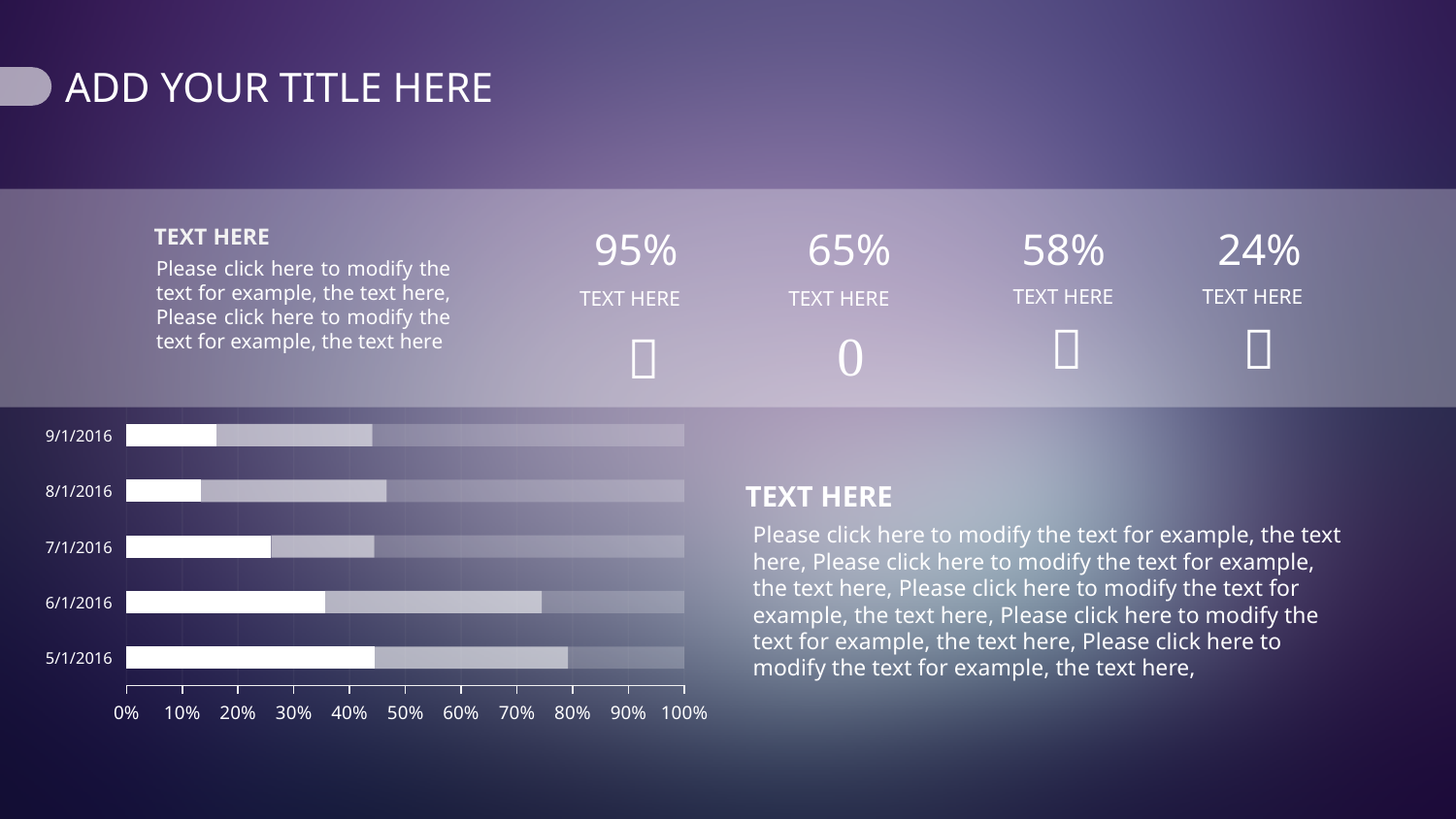
Which has the longer white (first) segment, 6/1/2016 or 7/1/2016? 6/1/2016 What is the interval between tick labels on the horizontal axis of the bar chart? 10% Which has the longer white (first) segment, 5/1/2016 or 9/1/2016? 5/1/2016 Which date has the longest white (first) segment in the bar chart? 5/1/2016 What kind of chart is shown on the slide? bar chart Is the white (first) segment for 7/1/2016 greater or less than 30%? less What is the maximum value shown on the horizontal axis of the bar chart? 100% Is the white (first) segment for 6/1/2016 greater or less than 40%? less Is the white (first) segment for 8/1/2016 greater or less than 20%? less How many date categories are shown on the bar chart? 5